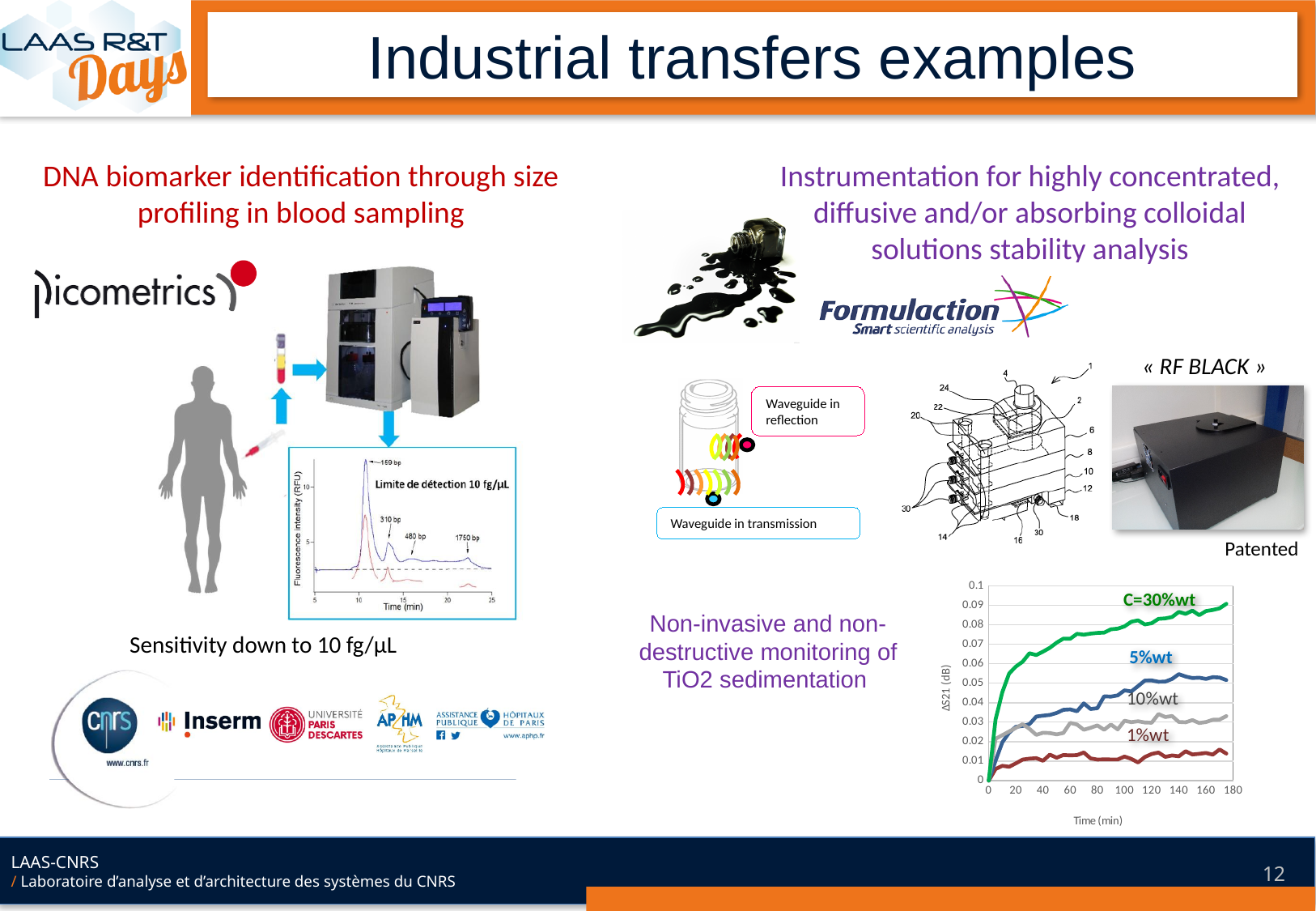
In the bottom-right ΔS21 chart, which concentration series has the lowest ΔS21 values? 1%wt In the bottom-right ΔS21 chart, how many concentration series are plotted? 4 In the bottom-right ΔS21 chart, is the value of the 10%wt series at 180 min greater or less than 0.04? less In the bottom-right ΔS21 chart, which concentration series reaches the highest ΔS21 values? C=30%wt What kind of chart is the bottom-right chart with the ΔS21 (dB) axis? line chart In the bottom-right ΔS21 chart, is the value of the C=30%wt series at 180 min greater or less than 0.08? greater In the left fluorescence intensity chart, how many peaks are labeled with a bp size? 4 What is the x-axis label of the bottom-right ΔS21 chart? Time (min) In the bottom-right ΔS21 chart, is the value of the 1%wt series at 180 min greater or less than 0.02? less In the left fluorescence intensity chart, which labeled peak is the highest? 169 bp In the bottom-right ΔS21 chart, which series is higher at 180 min, 5%wt or 10%wt? 5%wt In the bottom-right ΔS21 chart, do the ΔS21 values rise or fall as time increases? rise